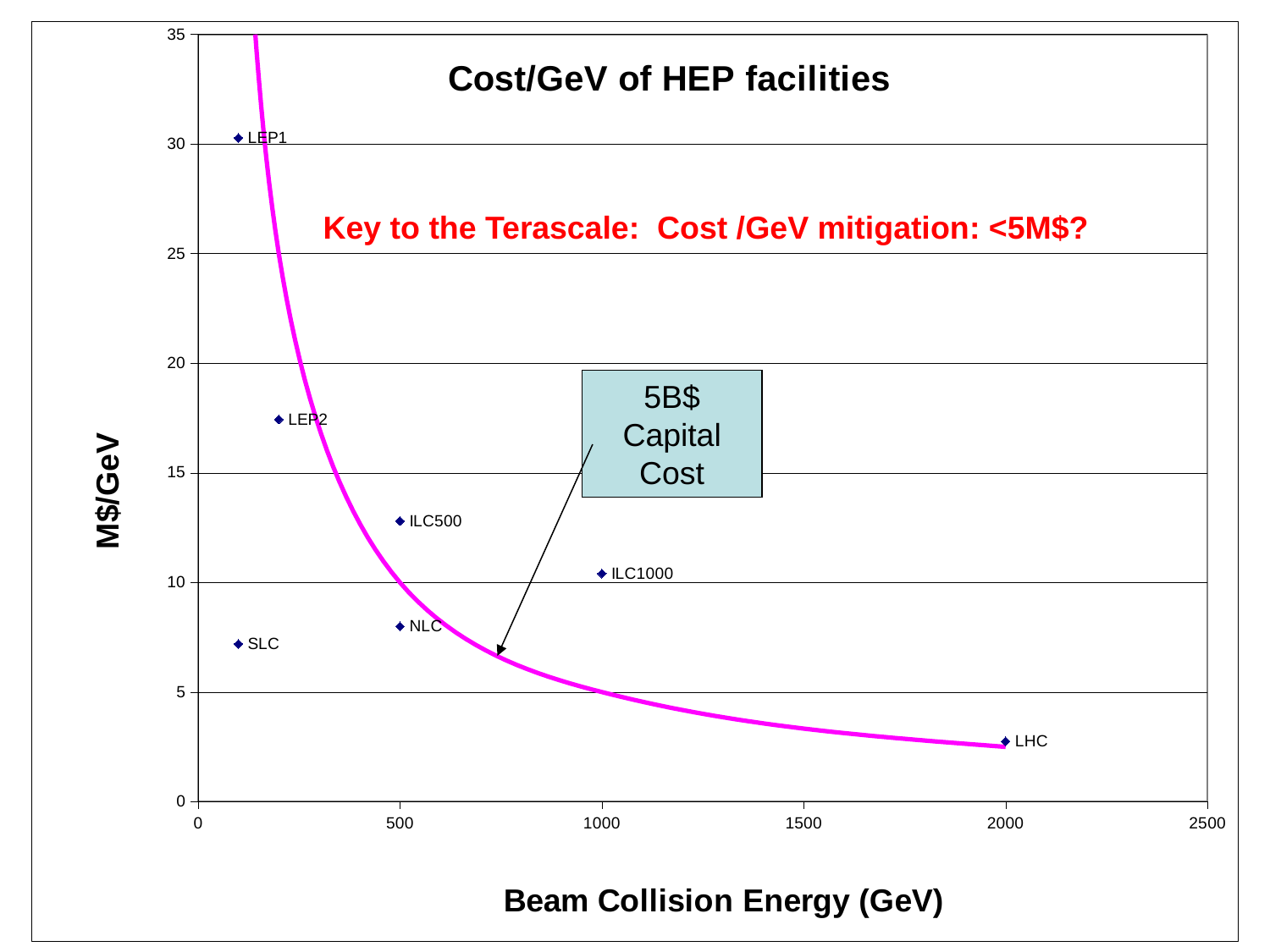
Which has a higher M$/GeV value, NLC or ILC1000? ILC1000 Which facility has the highest cost per GeV (M$/GeV)? LEP1 Is the M$/GeV value for LEP2 greater or less than 20? less How many labeled data points are plotted on the chart? 7 Is the M$/GeV value for LHC greater or less than 5? less Which has a higher M$/GeV value, LEP2 or ILC500? LEP2 Is the M$/GeV value for LEP1 greater or less than 25? greater Does the fitted curve rise or fall as beam collision energy increases? fall What kind of chart is shown on the slide? scatter chart Which facility has the lowest cost per GeV (M$/GeV)? LHC What is the title of the chart? Cost/GeV of HEP facilities